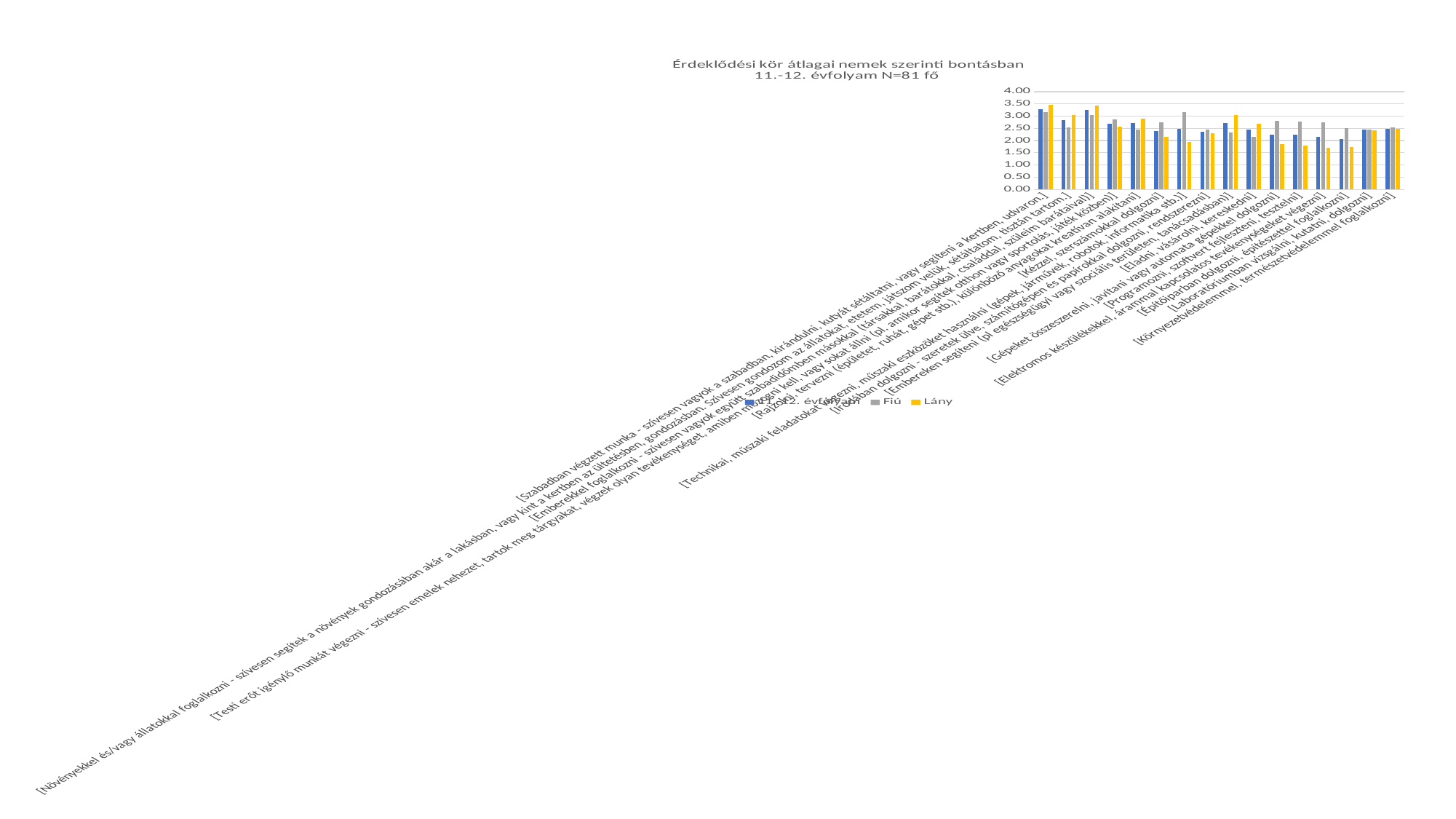
For the category 'Programozni, szoftvert fejleszteni, tesztelni', which is larger: the Fiú value or the Lány value? Fiú Is the Fiú value for the category 'Technikai, műszaki feladatokat végezni' greater or less than 3.00? greater What is the title of the chart? Érdeklődési kör átlagai nemek szerinti bontásban 11.-12. évfolyam N=81 fő For the category 'Elektromos készülékekkel, árammal kapcsolatos tevékenységet végezni', which is larger: the Fiú value or the Lány value? Fiú How many categories are plotted on the x axis? 16 What kind of chart is shown on the slide? bar chart How many series does the legend list? 3 For the category 'Embereken segíteni', which is larger: the Fiú value or the Lány value? Lány What are the three series named in the legend? 11.-12. évfolyam, Fiú, Lány Is the Lány value for the category 'Gépeket összeszerelni, javítani vagy automata gépekkel dolgozni' greater or less than 2.00? less